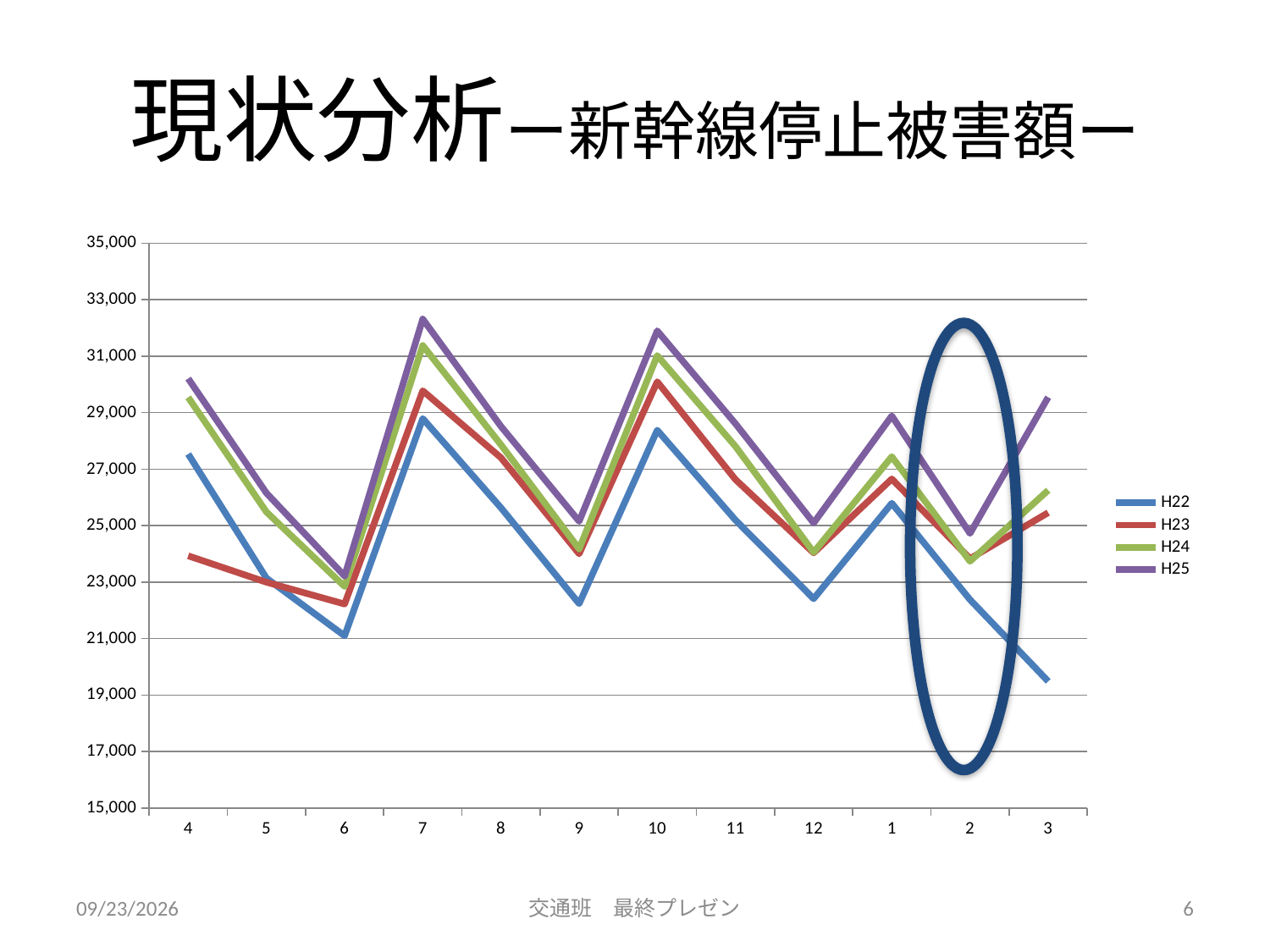
Is the value for H23 at x = 4 greater or less than 23,000? greater Is the value for H22 at x = 3 greater or less than 21,000? less How many series does the legend list? 4 At x = 3, which is larger: the value for H22 or the value for H25? H25 Which series has the highest value at x = 7? H25 Is the value for H22 at x = 9 greater or less than 23,000? less How many points are plotted along the x axis for each series? 12 Which series has the lowest value at x = 3? H22 Does the H22 series rise or fall from x = 1 to x = 3? fall What kind of chart is shown on the slide? line chart Which series is drawn in blue? H22